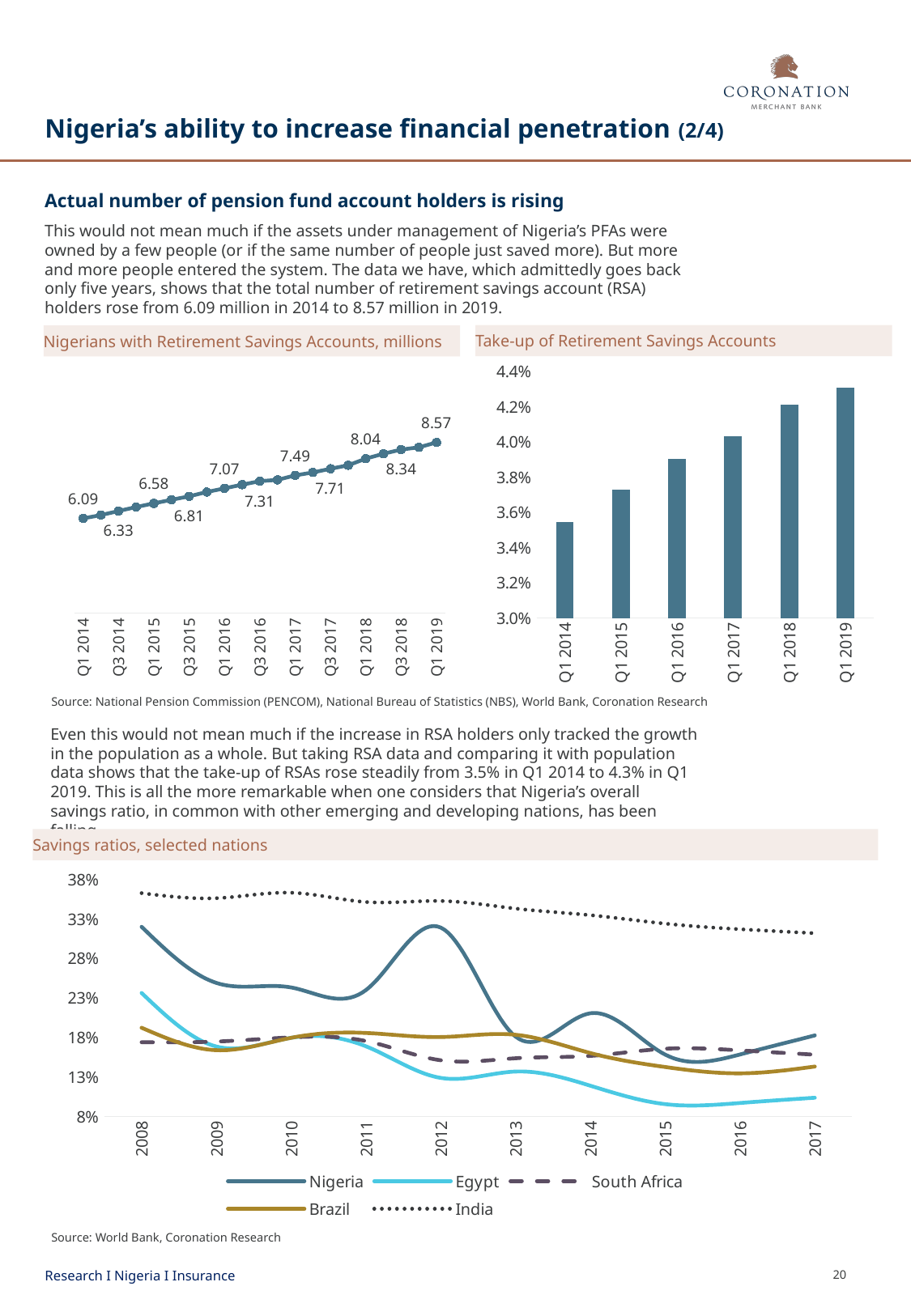
In the chart 'Nigerians with Retirement Savings Accounts, millions', what is the value for Q1 2019? 8.57 In the chart 'Take-up of Retirement Savings Accounts', how many bars are shown? 6 In the chart 'Savings ratios, selected nations', how many series does the legend list? 5 In the chart 'Nigerians with Retirement Savings Accounts, millions', do the values rise or fall from Q1 2014 to Q1 2019? rise In the chart 'Nigerians with Retirement Savings Accounts, millions', what is the difference between the Q1 2019 value and the Q1 2014 value? 2.48 In the chart 'Take-up of Retirement Savings Accounts', is the value for Q1 2014 greater or less than 3.6%? less In the chart 'Nigerians with Retirement Savings Accounts, millions', what is the value labelled for Q3 2017? 7.71 In the chart 'Nigerians with Retirement Savings Accounts, millions', what is the value for Q1 2014? 6.09 What kind of chart is 'Take-up of Retirement Savings Accounts'? bar chart In the chart 'Take-up of Retirement Savings Accounts', which quarter has the highest value? Q1 2019 In the chart 'Take-up of Retirement Savings Accounts', is the value for Q1 2016 greater or less than 3.8%? greater In the chart 'Savings ratios, selected nations', which nation has the highest savings ratio in 2017? India